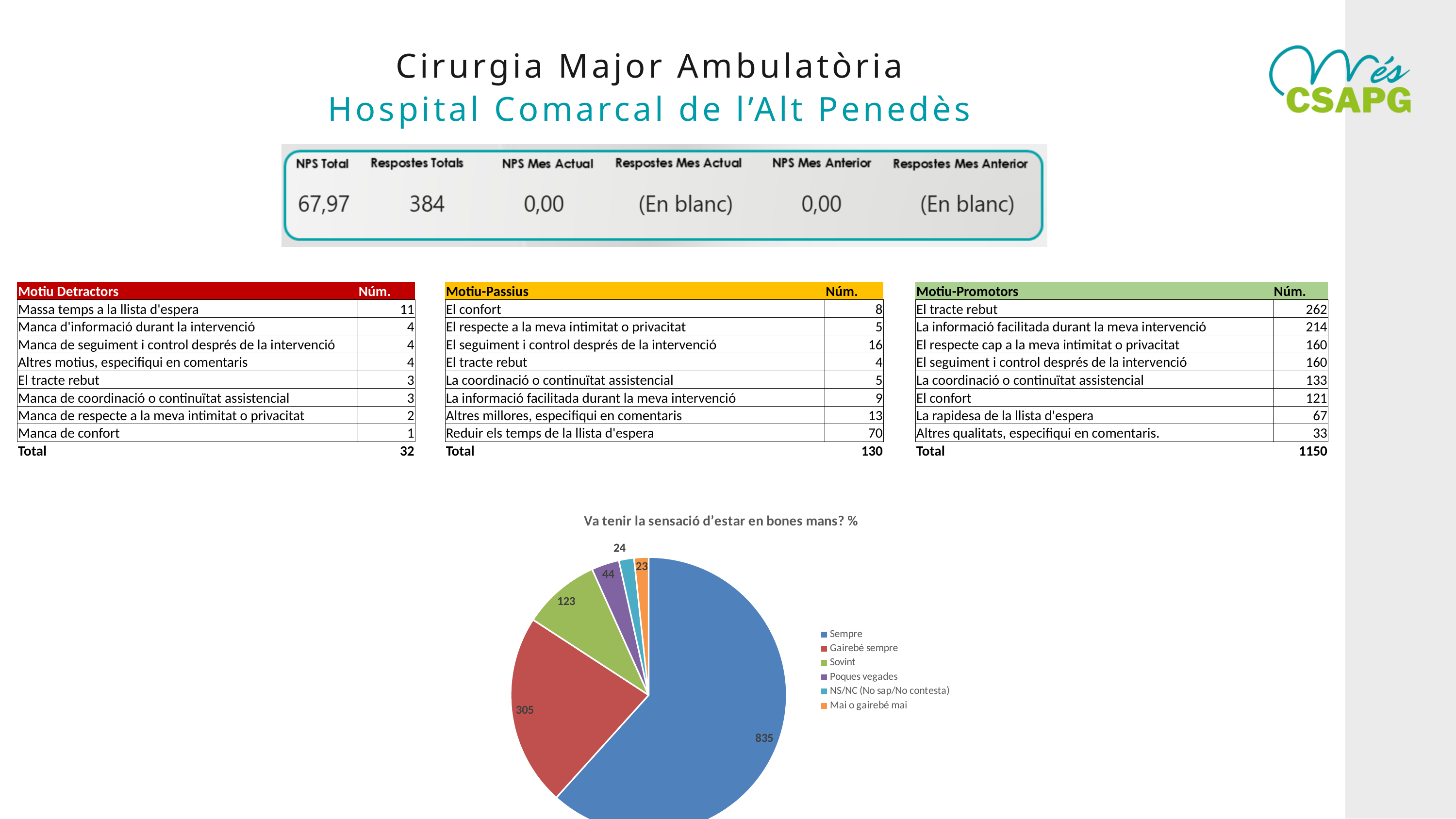
What is the value for "Sovint" in the pie chart? 123 Which is larger, the value for "Sovint" or the value for "Poques vegades"? Sovint What is the title of the pie chart? Va tenir la sensació d’estar en bones mans? % Which category has the smallest slice in the pie chart? Mai o gairebé mai What is the value for "Poques vegades" in the pie chart? 44 Which category has the largest slice in the pie chart? Sempre How many categories does the pie chart have? 6 What colour is the "Sempre" slice in the pie chart? blue What is the value for "Sempre" in the pie chart? 835 What is the difference between the values for "Sempre" and "Gairebé sempre"? 530 What is the value for "Gairebé sempre" in the pie chart? 305 What type of chart is shown on the slide? pie chart